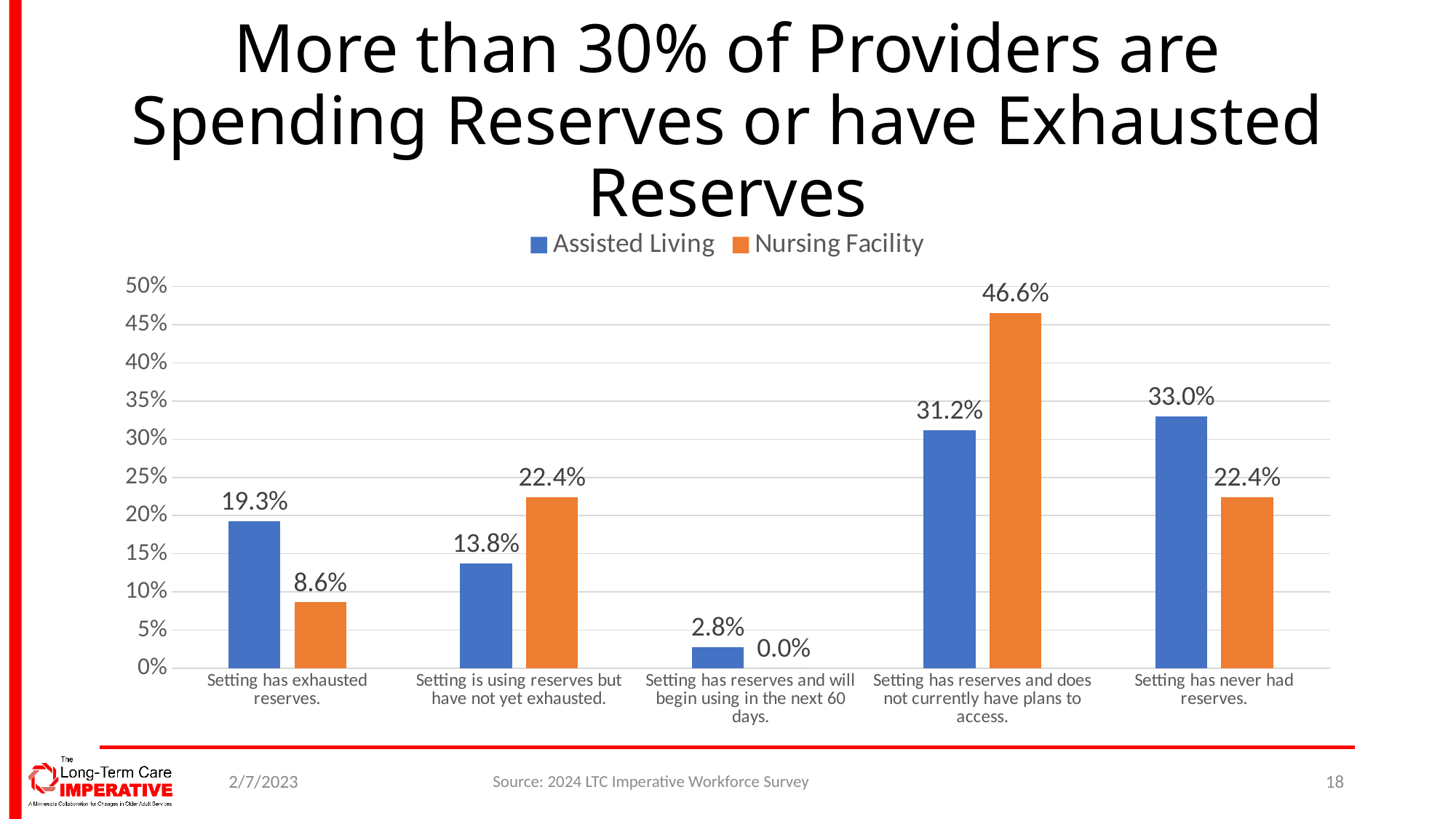
How many series does the legend list? 2 What is the Nursing Facility value for "Setting has reserves and will begin using in the next 60 days."? 0.0% How many categories are shown on the x axis? 5 What kind of chart is shown on the slide? Bar chart For "Setting has exhausted reserves.", which series has the larger value, Assisted Living or Nursing Facility? Assisted Living What is the Assisted Living value for "Setting has exhausted reserves."? 19.3% What is the difference between the Nursing Facility and Assisted Living values for "Setting has reserves and does not currently have plans to access."? 15.4% Which category has the highest Assisted Living value? Setting has never had reserves. What is the Nursing Facility value for "Setting has reserves and does not currently have plans to access."? 46.6% Is the Assisted Living value for "Setting has never had reserves." greater or less than 30%? greater Which category has the lowest Nursing Facility value? Setting has reserves and will begin using in the next 60 days. Which series is shown in orange? Nursing Facility